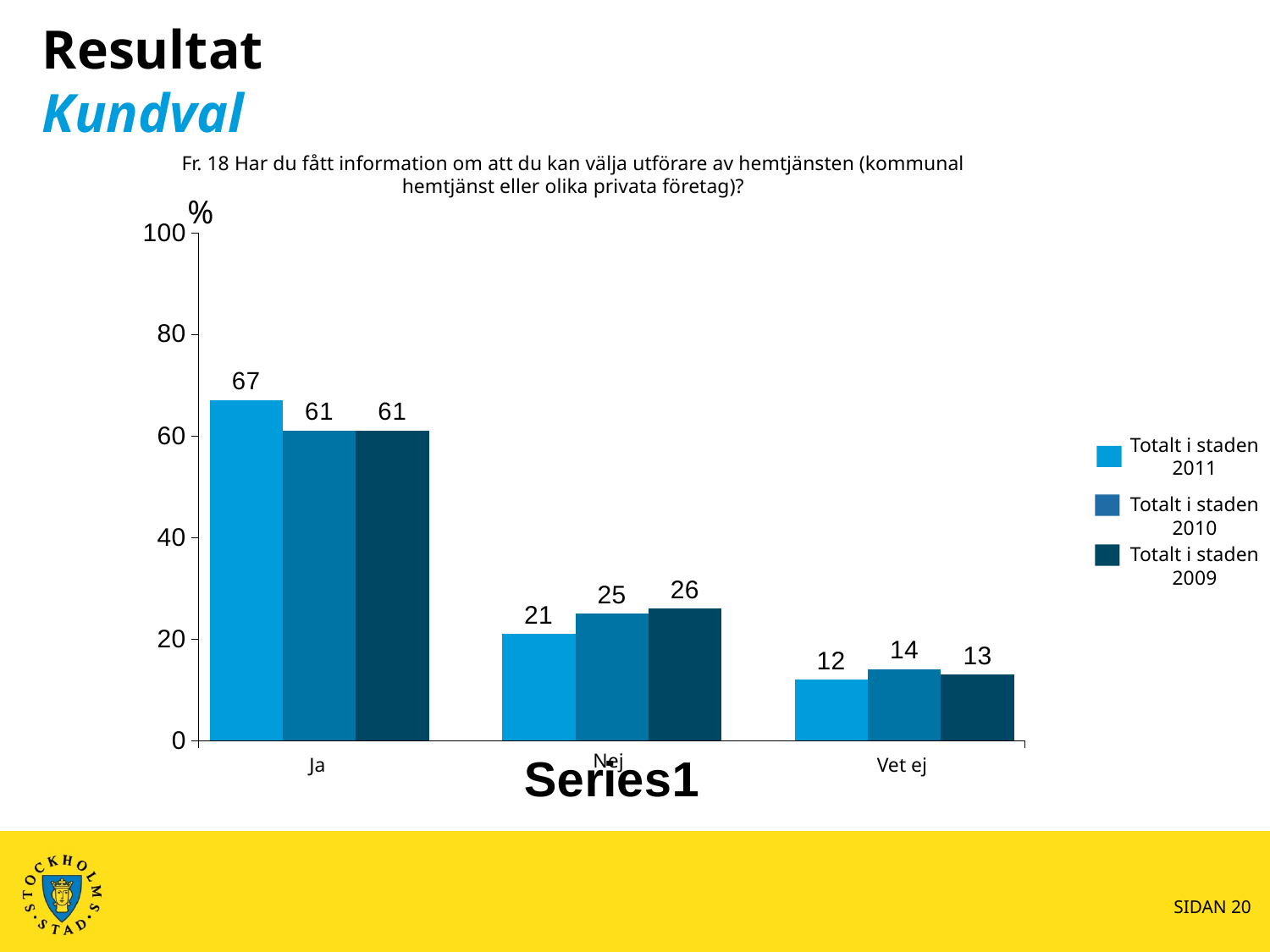
What is the value for "Ja" in the "Totalt i staden 2011" series? 67 Which is larger for "Nej": the value for "Totalt i staden 2011" or for "Totalt i staden 2009"? Totalt i staden 2009 How many series does the legend list? 3 What is the value for "Vet ej" in the "Totalt i staden 2010" series? 14 What is the difference between the "Ja" values for "Totalt i staden 2011" and "Totalt i staden 2010"? 6 Is the value for "Ja" in the "Totalt i staden 2011" series greater or less than 60? greater Which category has the highest value in the "Totalt i staden 2011" series? Ja What kind of chart is shown on the slide? bar chart What unit is shown at the top of the vertical axis? % What is the value for "Nej" in the "Totalt i staden 2009" series? 26 How many categories are shown on the x axis? 3 Which category has the lowest value in the "Totalt i staden 2009" series? Vet ej